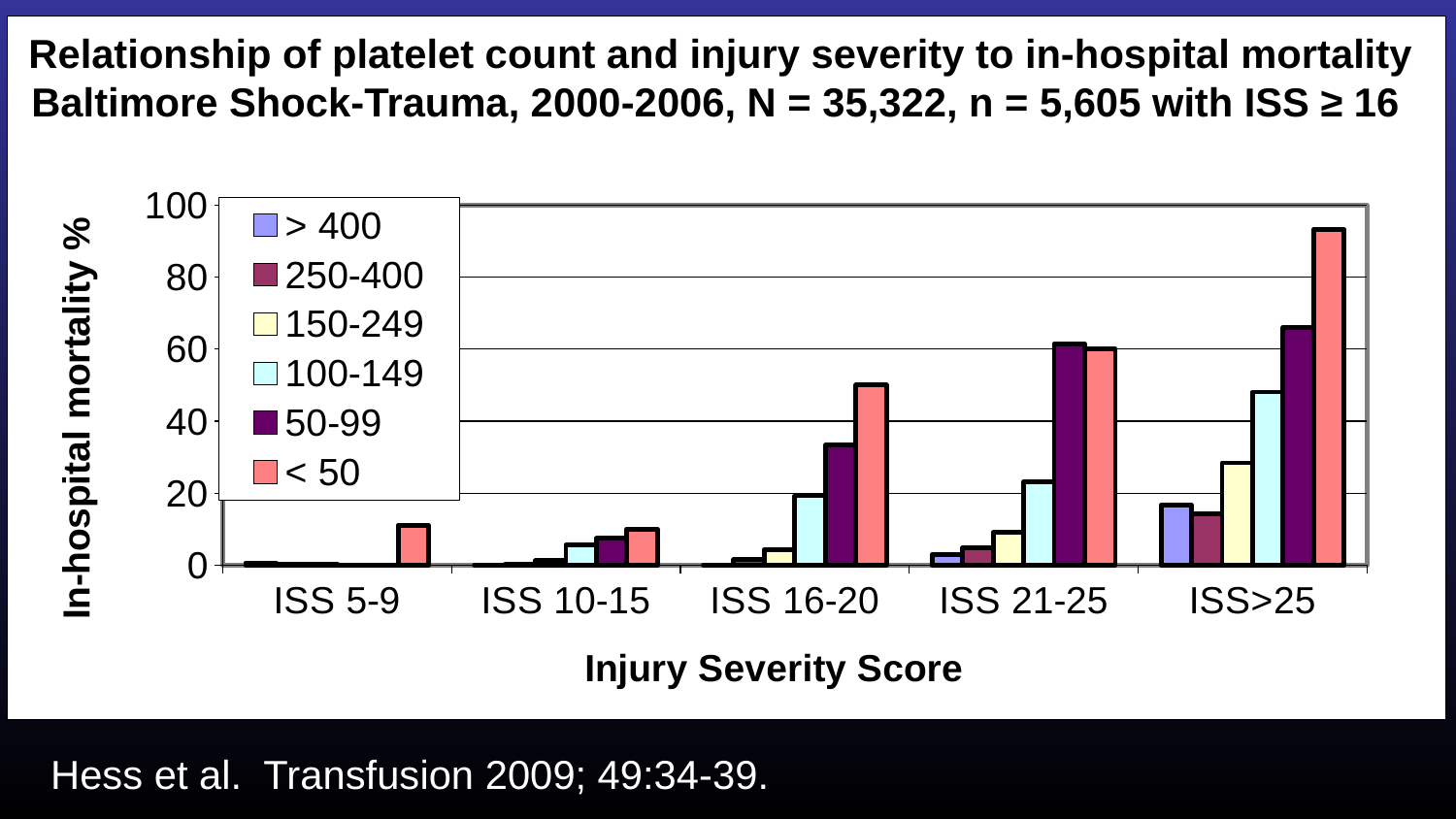
How many series does the legend list? 6 Is the in-hospital mortality for the 50-99 series in the ISS 16-20 group greater or less than 40? less Is the in-hospital mortality for the < 50 series in the ISS>25 group greater or less than 80? greater Is the in-hospital mortality for the 150-249 series in the ISS>25 group greater or less than 20? greater In the ISS>25 group, which is larger: the in-hospital mortality for the 100-149 series or the 150-249 series? 100-149 Does the in-hospital mortality for the < 50 series rise or fall as the Injury Severity Score increases along the x axis? rise What is the title of the y axis? In-hospital mortality % What kind of chart is shown on the slide? bar chart How many Injury Severity Score categories are shown on the x axis? 5 Which platelet count series has the highest in-hospital mortality in the ISS 16-20 group? < 50 Which platelet count series has the highest in-hospital mortality in the ISS>25 group? < 50